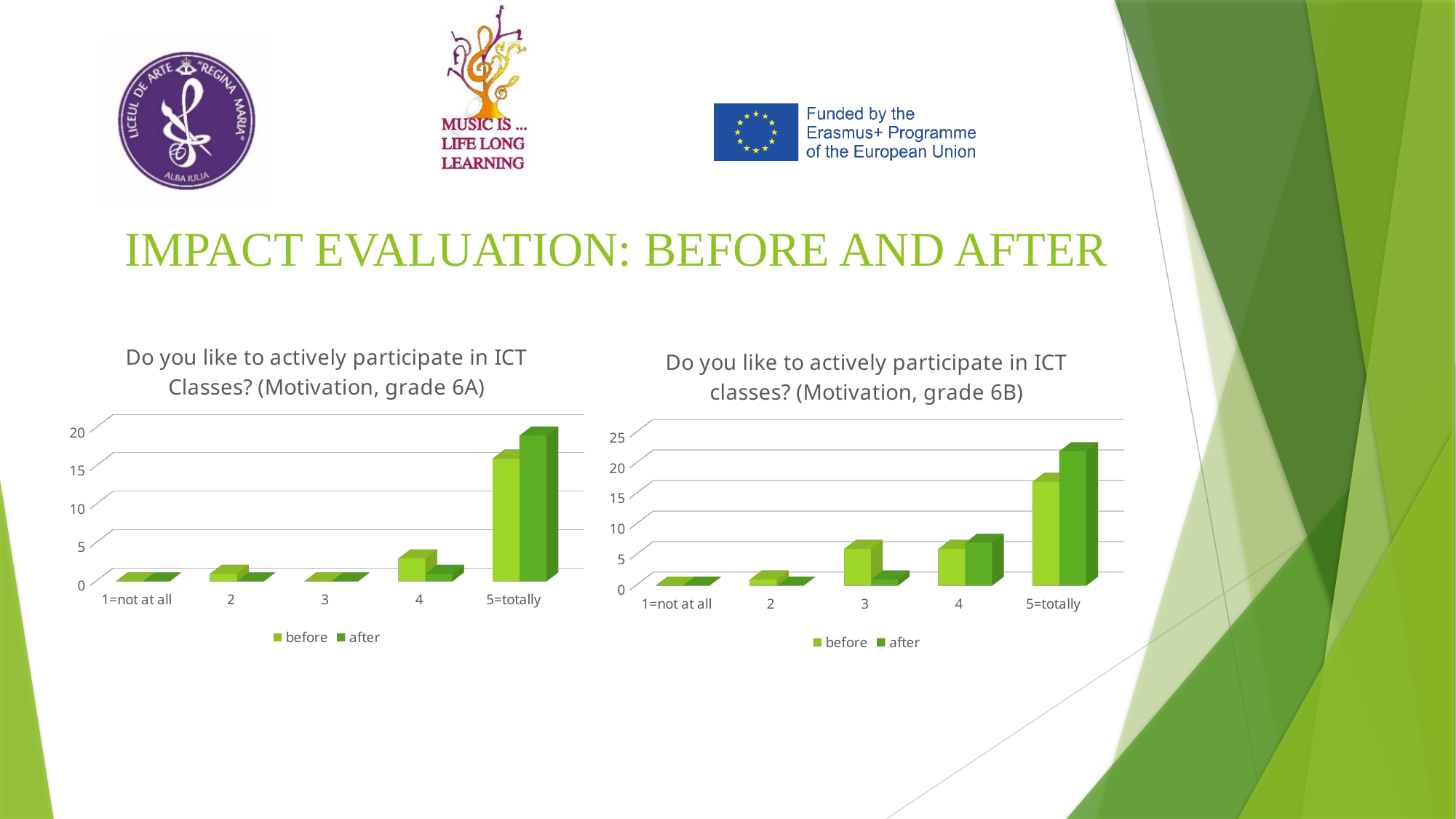
In the left chart (grade 6A), which category has the highest 'after' value? 5=totally In the right chart (grade 6B), is the 'before' value for 3 greater or less than 10? less In the left chart (grade 6A), how many categories are shown on the x axis? 5 In the right chart (grade 6B), how many series does the legend list? 2 In the right chart (grade 6B), is the 'after' value for 5=totally greater or less than 20? greater What are the two legend entries in the right chart (grade 6B)? before, after In the left chart (grade 6A), what kind of chart is shown? bar chart In the right chart (grade 6B), which category has the highest 'before' value? 5=totally In the left chart (grade 6A), is the 'after' value for 5=totally greater or less than 15? greater In the left chart (grade 6A), which is larger for 4, the 'before' value or the 'after' value? before In the right chart (grade 6B), which is larger for 3, the 'before' value or the 'after' value? before In the left chart (grade 6A), which is larger for 5=totally, the 'before' value or the 'after' value? after